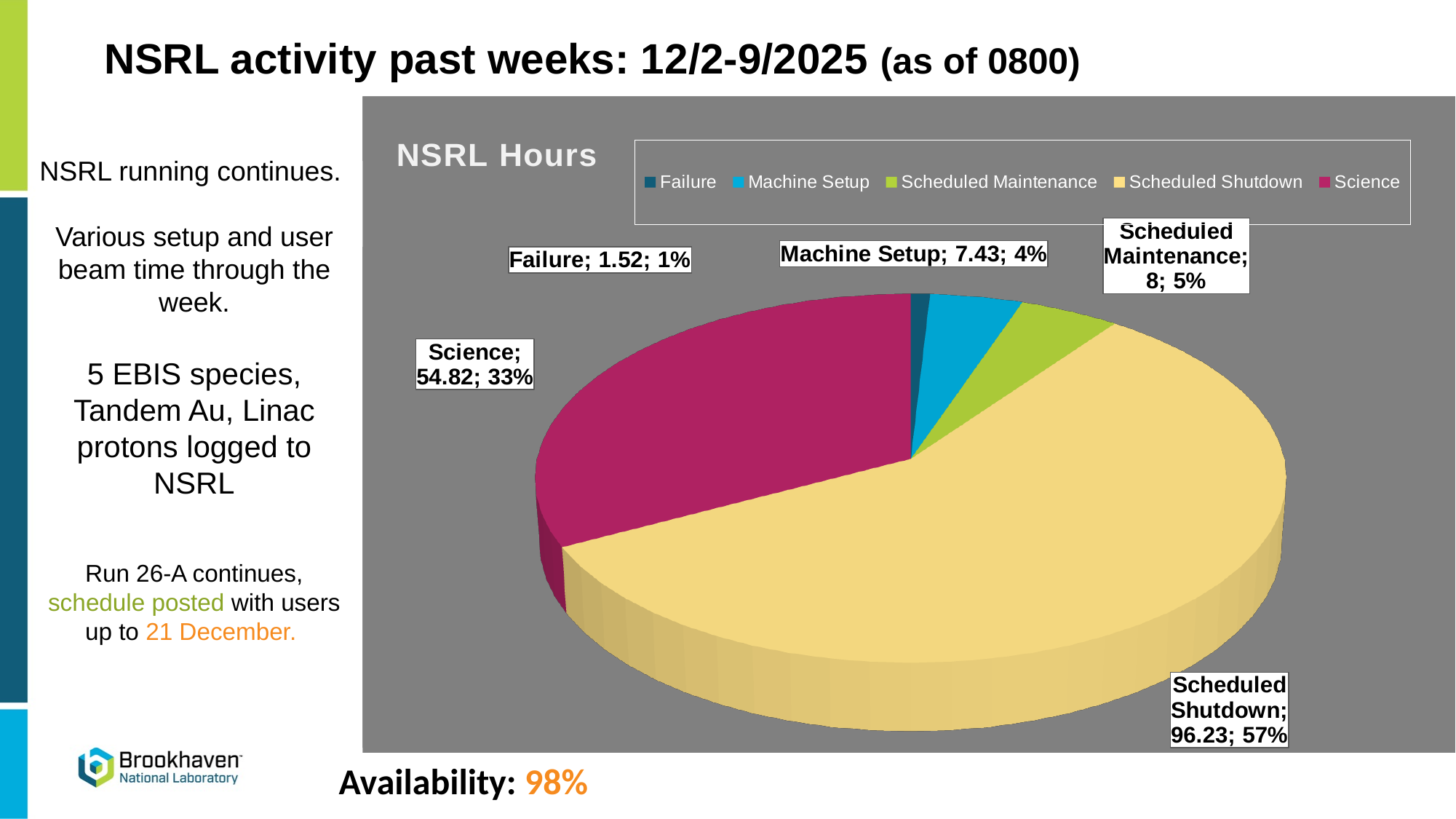
Which category has the smallest slice? Failure What kind of chart is shown on the slide? Pie chart What share of the pie does Science represent? 33% What share of the pie does Scheduled Maintenance represent? 5% How many hours are shown for Scheduled Shutdown? 96.23 How many categories does the legend list? 5 What is the difference in hours between Scheduled Shutdown and Science? 41.41 How many hours are shown for Failure? 1.52 What is the title of the chart? NSRL Hours Which category has the largest slice? Scheduled Shutdown How many hours are shown for Machine Setup? 7.43 How many hours are shown for Science? 54.82